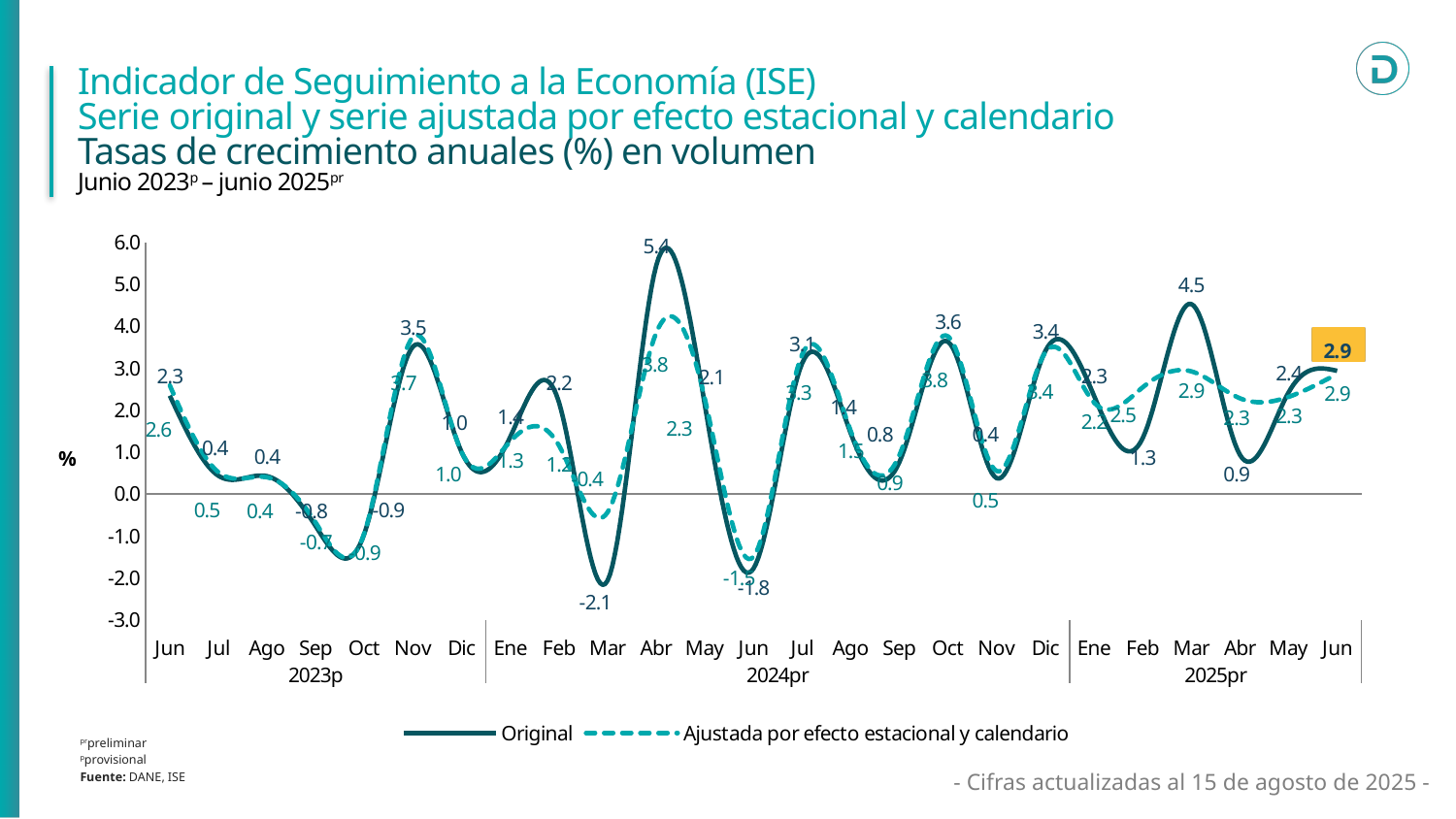
Which is larger in November 2023: the Original value (3.5) or the Ajustada value (3.7)? Ajustada por efecto estacional y calendario What type of chart is shown on the slide? line chart In which month does the Original series reach its highest value? Abr 2024pr In which month does the Original series reach its lowest value? Mar 2024pr What is the value of the Original series in March 2025 (Mar 2025pr)? 4.5 What is the value of the Original series in June 2025 (Jun 2025pr)? 2.9 How many series does the legend list? 2 What is the unit shown on the y axis of the chart? % What is the value of the Original series in October 2024 (Oct 2024pr)? 3.6 What is the value of the Original series in April 2024 (Abr 2024pr)? 5.4 What is the difference between the Original value in April 2024 (5.4) and the Original value in March 2025 (4.5)? 0.9 What is the value of the Original series in March 2024 (Mar 2024pr)? -2.1